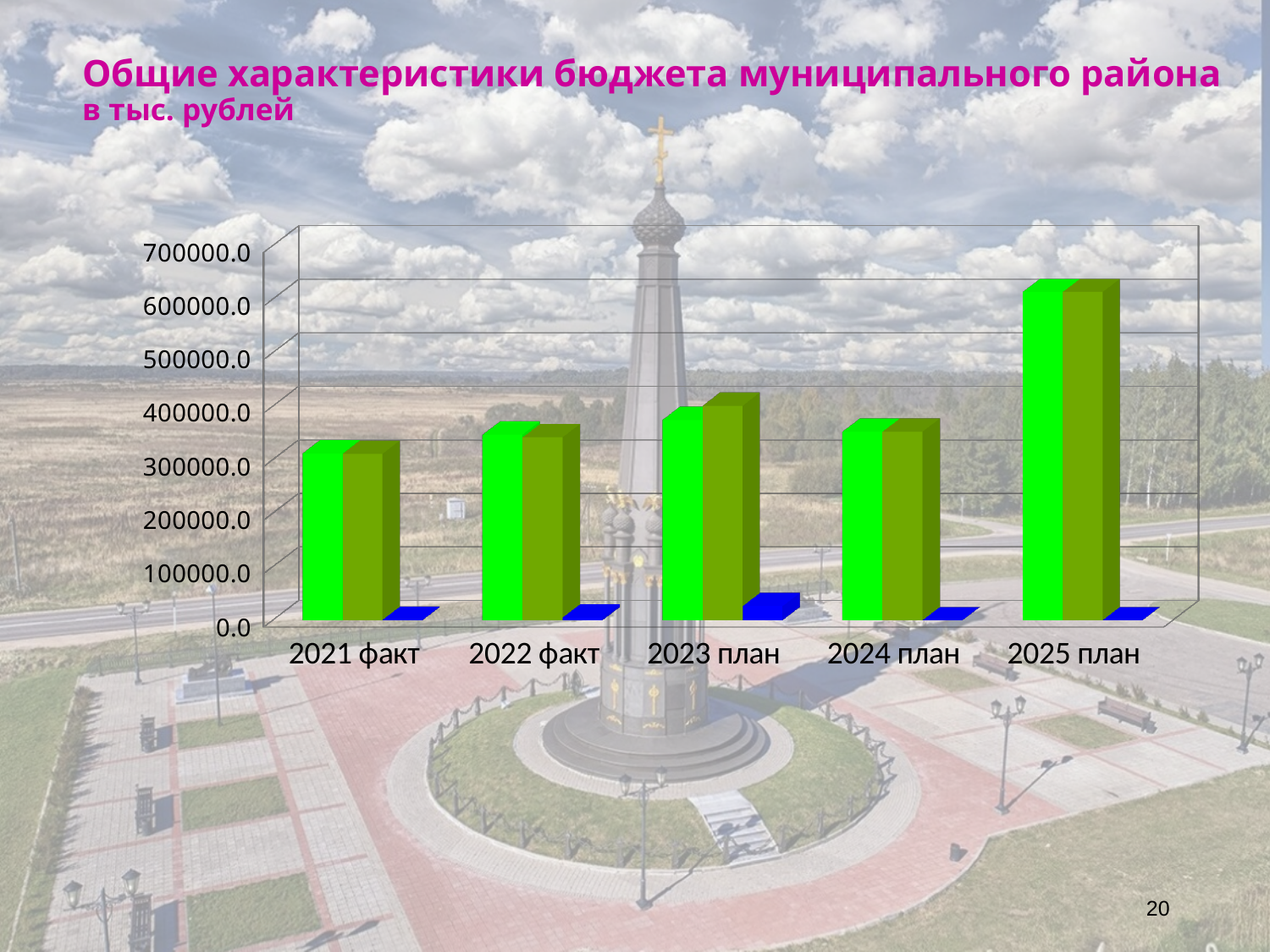
Is the green bar for 2025 план greater or less than 500000.0? greater In what units are the values on the chart expressed, according to the slide? в тыс. рублей Is the green bar for 2021 факт greater or less than 200000.0? greater Is the green bar for 2025 план greater or less than 700000.0? less How many categories are shown on the x axis of the chart? 5 Which category has the tallest green bar? 2025 план Which green bar is taller, 2023 план or 2024 план? 2023 план Which green bar is taller, 2025 план or 2021 факт? 2025 план What kind of chart is shown on the slide? bar chart What is the title of the chart on the slide? Общие характеристики бюджета муниципального района